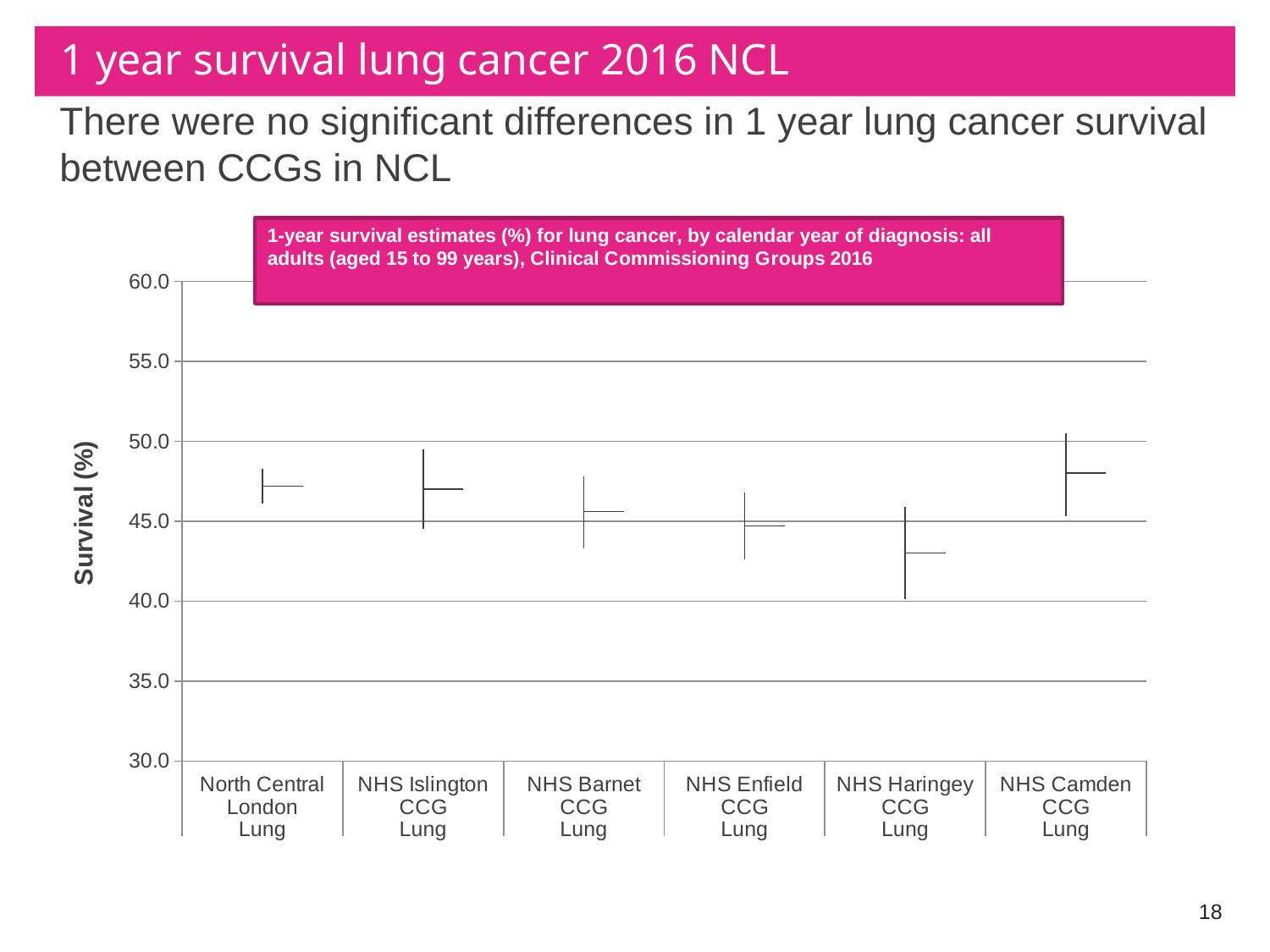
Which has the higher 1-year survival estimate, NHS Islington CCG or NHS Haringey CCG? NHS Islington CCG Is the 1-year survival estimate for NHS Islington CCG greater or less than 45.0? greater Is the 1-year survival estimate for NHS Haringey CCG greater or less than 45.0? less Which CCG has the lowest 1-year survival estimate on the chart? NHS Haringey CCG Is the 1-year survival estimate for NHS Camden CCG greater or less than 45.0? greater What is the lowest value shown on the vertical axis of the chart? 30.0 How many CCG categories are shown on the x axis of the chart? 6 Which has the higher 1-year survival estimate, NHS Camden CCG or NHS Enfield CCG? NHS Camden CCG What is the label on the vertical axis of the chart? Survival (%)